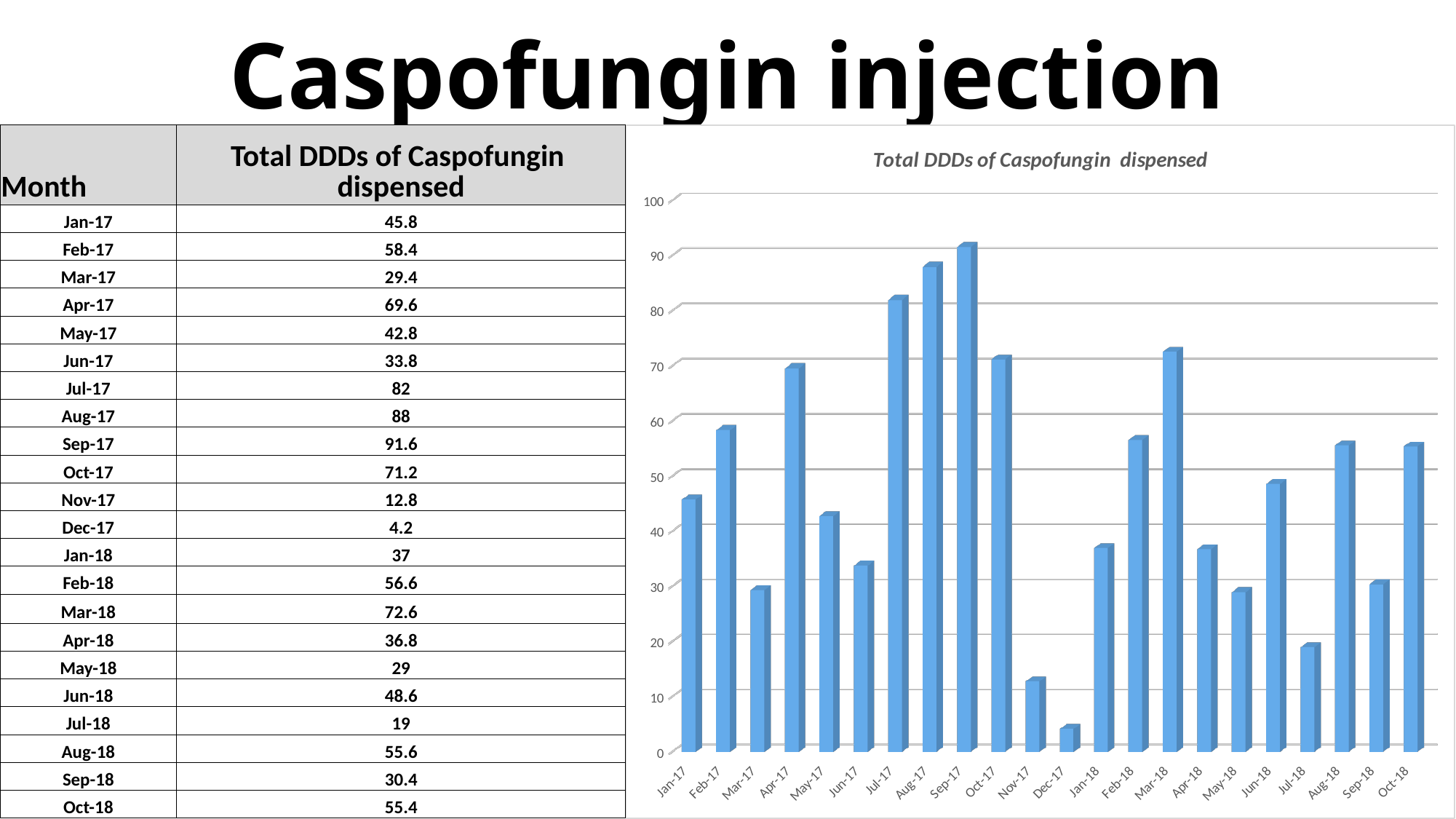
What is the total DDDs of Caspofungin dispensed in Sep-17? 91.6 Is the value for Jul-18 greater or less than 20? less Which month has the lowest total DDDs of Caspofungin dispensed? Dec-17 How many months are plotted on the chart? 22 What is the title of the chart? Total DDDs of Caspofungin dispensed Is the value for Jun-18 greater or less than 40? greater What is the total DDDs of Caspofungin dispensed in Mar-18? 72.6 Which month has a higher value, Apr-17 or Oct-17? Oct-17 Which month has the highest total DDDs of Caspofungin dispensed? Sep-17 What is the difference between the total DDDs dispensed in Aug-17 and Jul-17? 6 Do the values rise or fall from Jul-17 to Sep-17? rise What type of chart is shown on the slide? bar chart